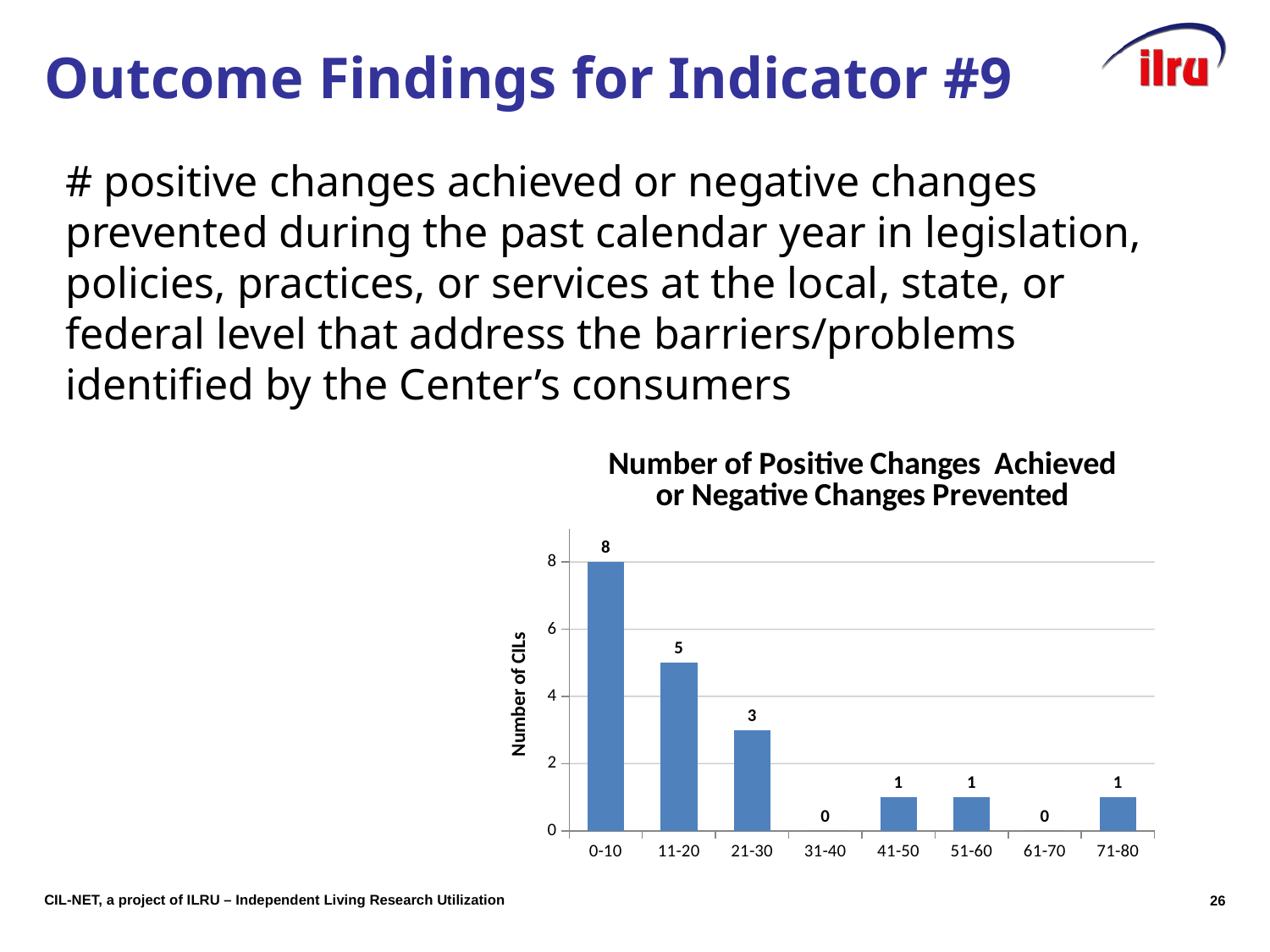
What is the number of CILs for the 21-30 category? 3 What is the difference in number of CILs between the 0-10 and 11-20 categories? 3 How many categories are shown on the x axis of the chart? 8 What kind of chart is shown on the slide? Bar chart What is the number of CILs for the 11-20 category? 5 What is the label of the y axis of the chart? Number of CILs What is the number of CILs for the 31-40 category? 0 What is the title of the chart? Number of Positive Changes Achieved or Negative Changes Prevented What is the number of CILs for the 0-10 category? 8 Which category has the highest number of CILs? 0-10 Which has more CILs, the 21-30 category or the 41-50 category? 21-30 Do the values generally rise or fall from the 0-10 category to the 21-30 category? Fall